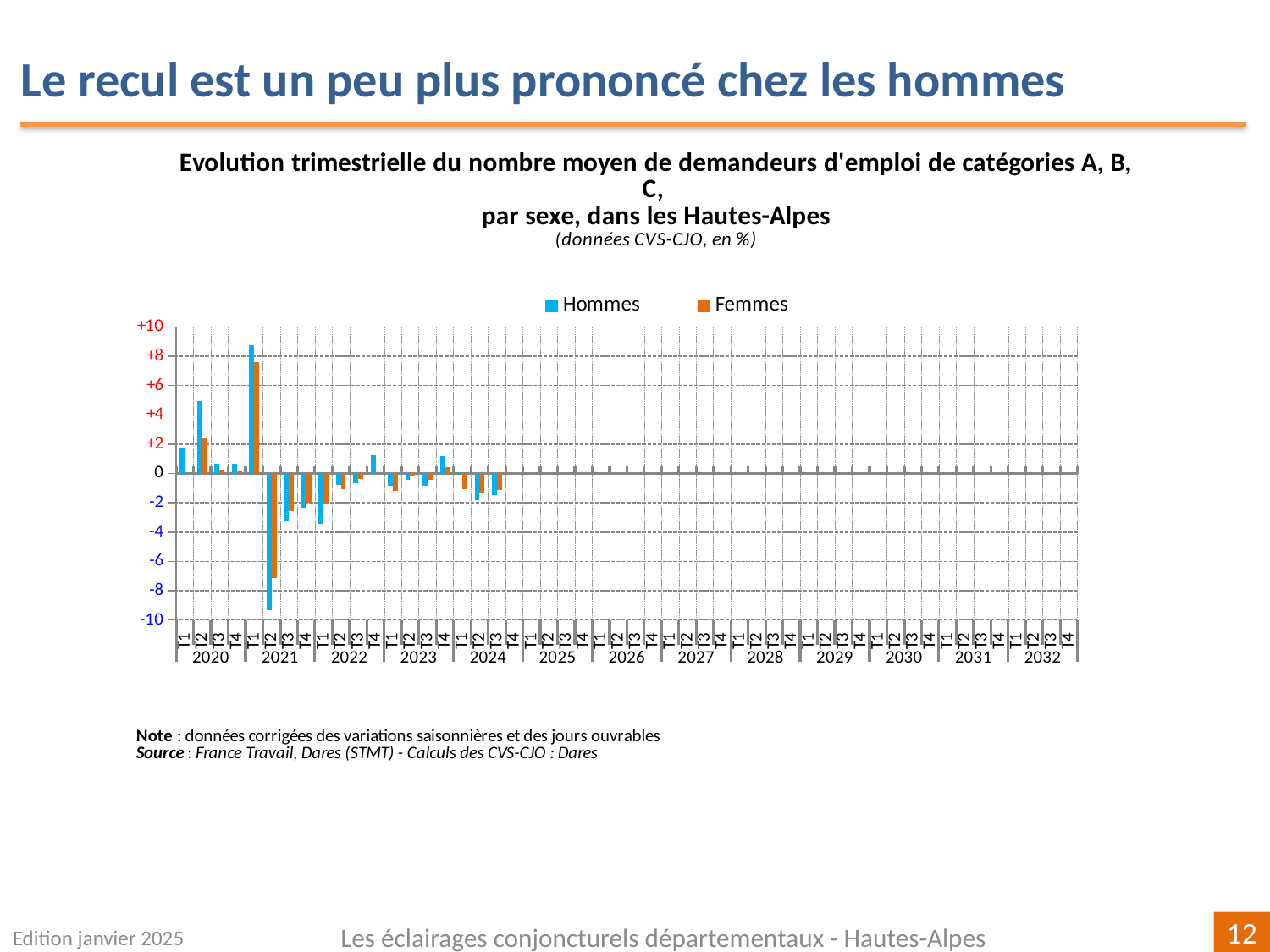
In which quarter does the Femmes series reach its lowest value? T2 2021 How many years are labelled along the x axis? 13 How many series does the legend list? 2 Which colour represents the Hommes series? blue In T1 2021, which series has the larger value, Hommes or Femmes? Hommes Is the Hommes value for T1 2021 greater or less than +8? greater What are the two series named in the legend? Hommes and Femmes Is the Hommes value for T2 2021 greater or less than -8? less In which quarter does the Hommes series reach its highest value? T1 2021 What kind of chart is shown on the slide? bar chart Is the Femmes value for T2 2021 greater or less than -6? less In which quarter does the Hommes series reach its lowest value? T2 2021